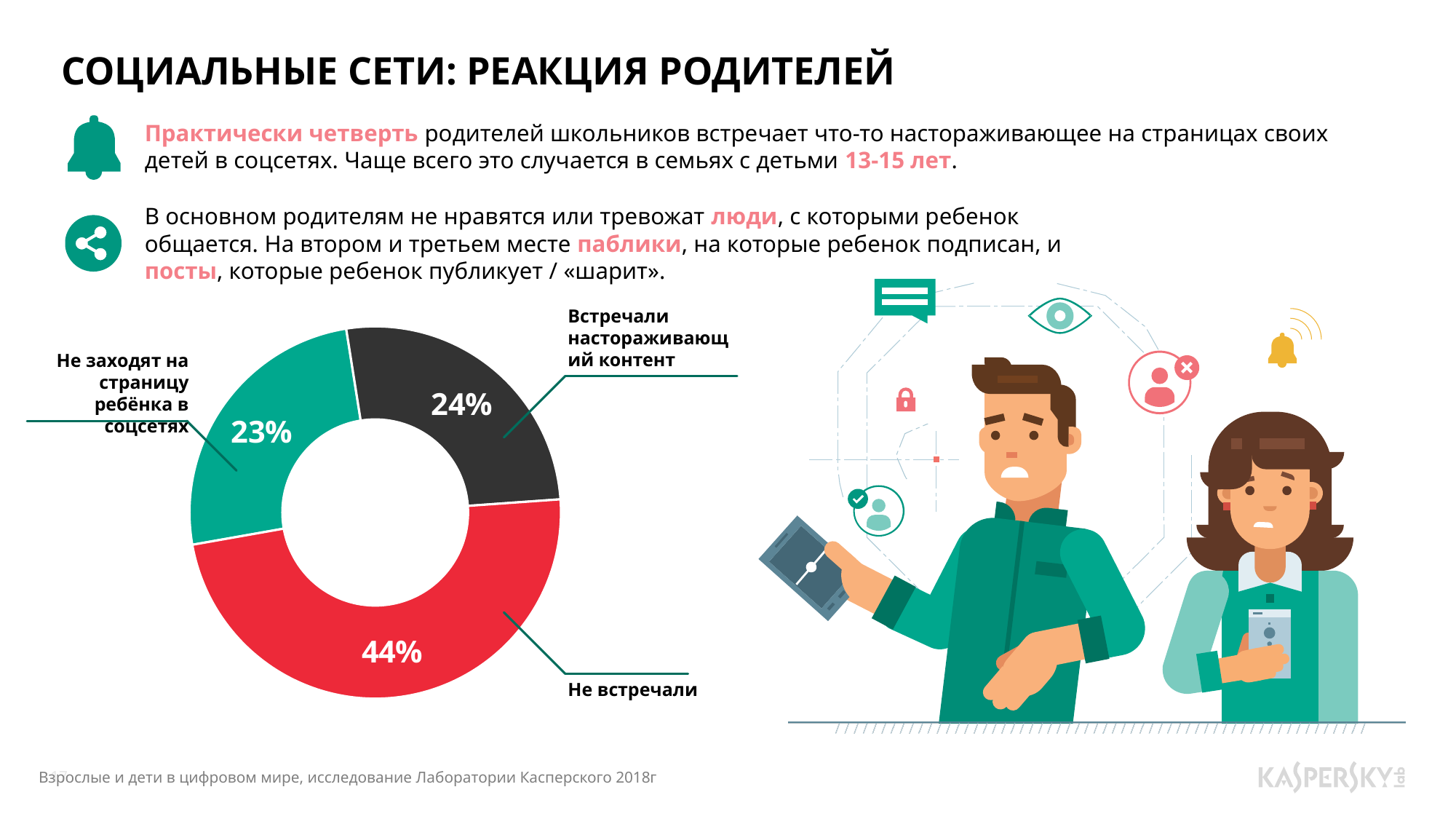
How many slices does the donut chart have? 3 What colour is the "Не заходят на страницу ребёнка в соцсетях" slice of the donut chart? Green What kind of chart is shown on the slide? Donut (pie) chart Which is larger: the share for "Встречали настораживающий контент" or for "Не заходят на страницу ребёнка в соцсетях"? Встречали настораживающий контент What is the difference between the "Встречали настораживающий контент" share and the "Не заходят на страницу ребёнка в соцсетях" share? 1% What share of parents "Встречали настораживающий контент"? 24% Which category has the smallest slice in the donut chart? Не заходят на страницу ребёнка в соцсетях What is the difference between the "Не встречали" share and the "Встречали настораживающий контент" share? 20% What share of parents "Не встречали"? 44% What share of parents "Не заходят на страницу ребёнка в соцсетях"? 23% Which category has the largest slice in the donut chart? Не встречали What colour is the "Не встречали" slice of the donut chart? Red